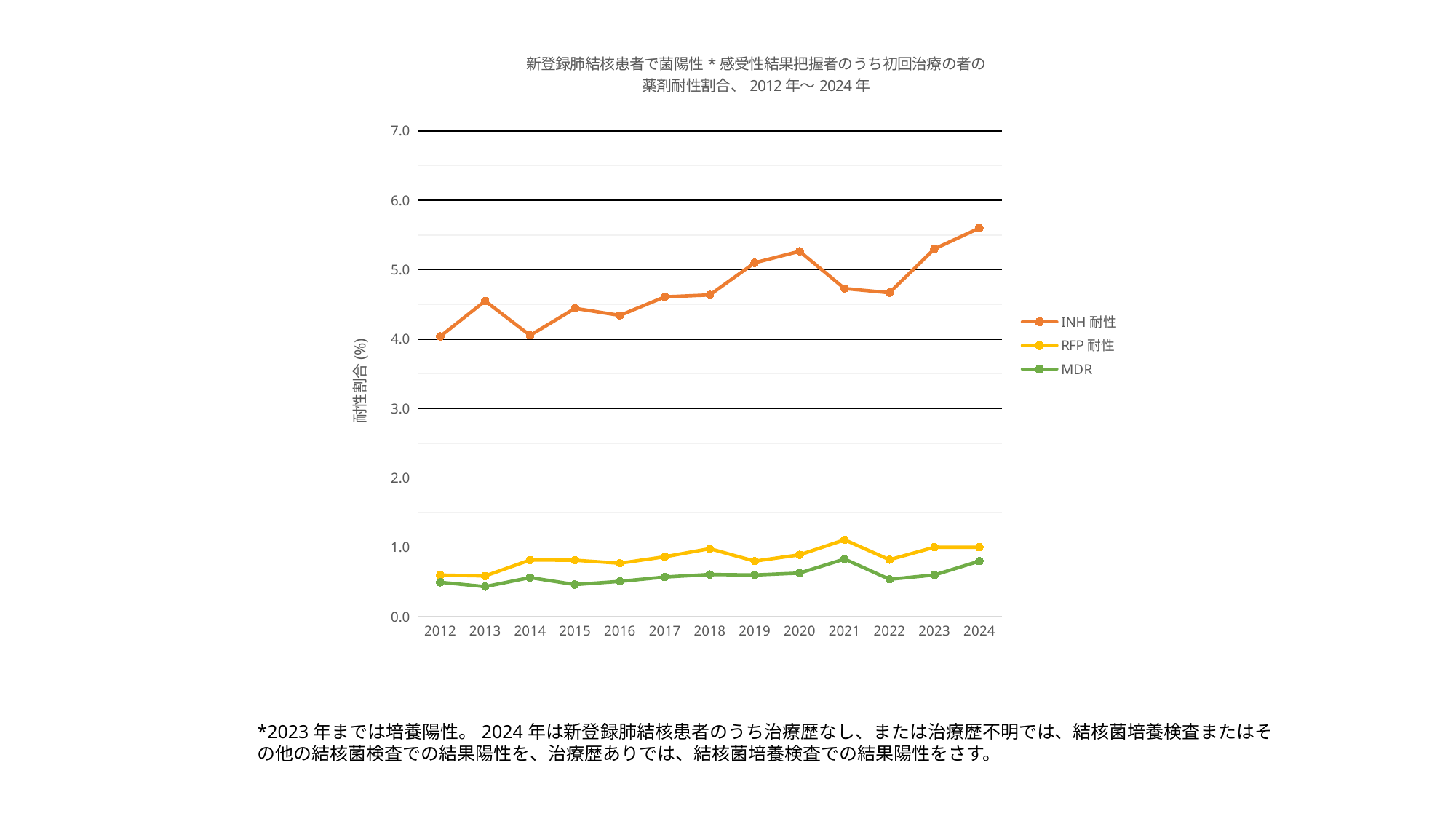
Is the INH 耐性 value for 2024 greater or less than 5.0? greater Is the MDR value for 2012 greater or less than 1.0? less How many years are plotted along the x axis? 13 In which year is the INH 耐性 value highest? 2024 What colour is the line for MDR? green What kind of chart is shown on the slide? line chart Is the RFP 耐性 value for 2021 greater or less than 1.0? greater How many series does the legend list? 3 In which year is the RFP 耐性 value highest? 2021 Does the INH 耐性 line generally rise or fall from 2012 to 2024? rise Which series has the larger value in 2024, INH 耐性 or MDR? INH 耐性